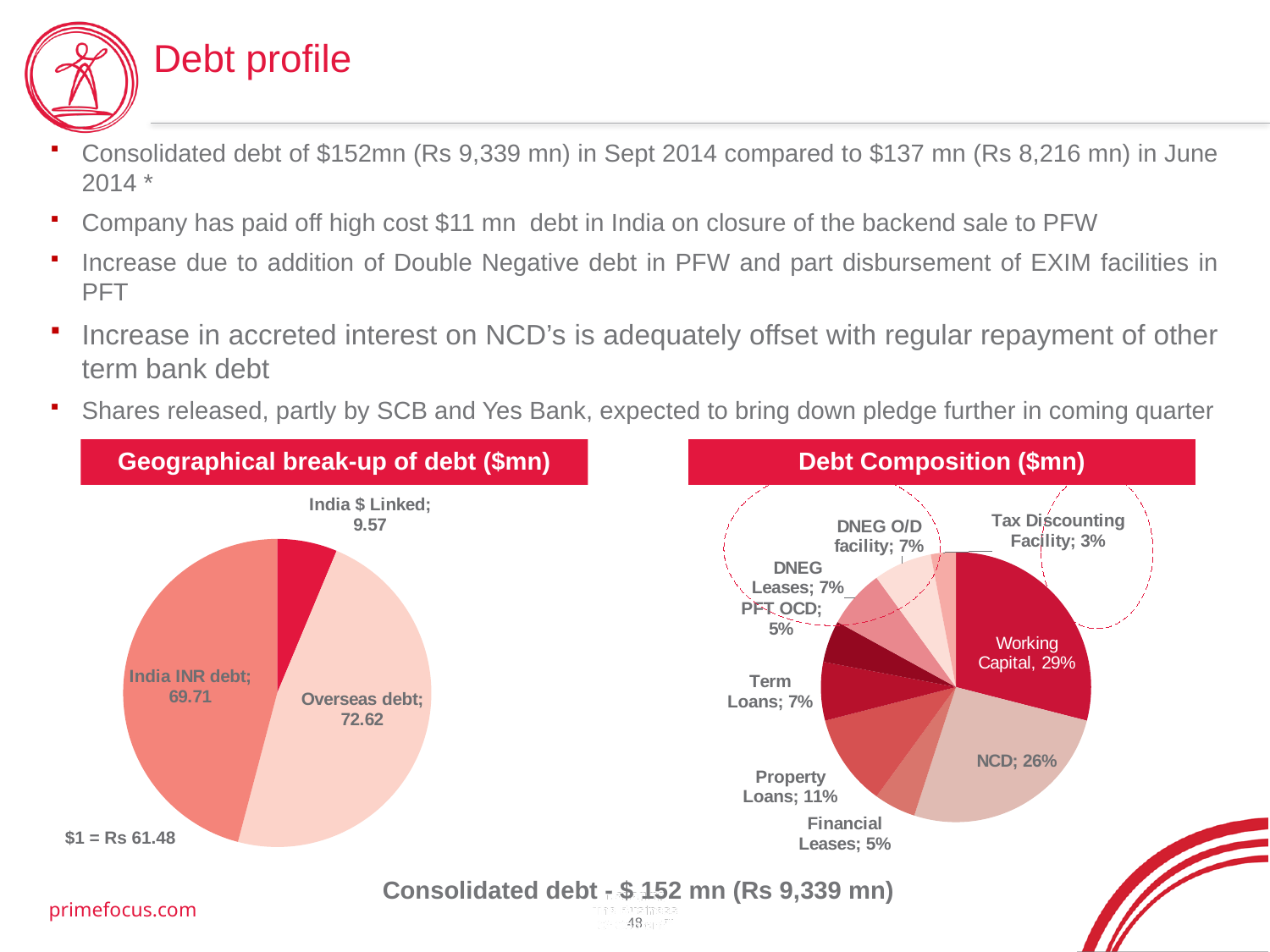
In the 'Debt Composition ($mn)' chart, what share does Property Loans have? 11% In the 'Debt Composition ($mn)' chart, which category has the largest share? Working Capital In the 'Geographical break-up of debt ($mn)' chart, how many categories are shown? 3 In the 'Geographical break-up of debt ($mn)' chart, what is the value for India $ Linked? 9.57 In the 'Debt Composition ($mn)' chart, what share does NCD have? 26% In the 'Debt Composition ($mn)' chart, how many categories are shown? 9 In the 'Debt Composition ($mn)' chart, which category has the smallest share? Tax Discounting Facility What kind of chart is the 'Geographical break-up of debt ($mn)' chart? Pie chart In the 'Debt Composition ($mn)' chart, which is larger: Term Loans or Financial Leases? Term Loans In the 'Geographical break-up of debt ($mn)' chart, what is the value for Overseas debt? 72.62 In the 'Geographical break-up of debt ($mn)' chart, what is the difference between Overseas debt and India INR debt? 2.91 In the 'Geographical break-up of debt ($mn)' chart, which category has the smallest value? India $ Linked